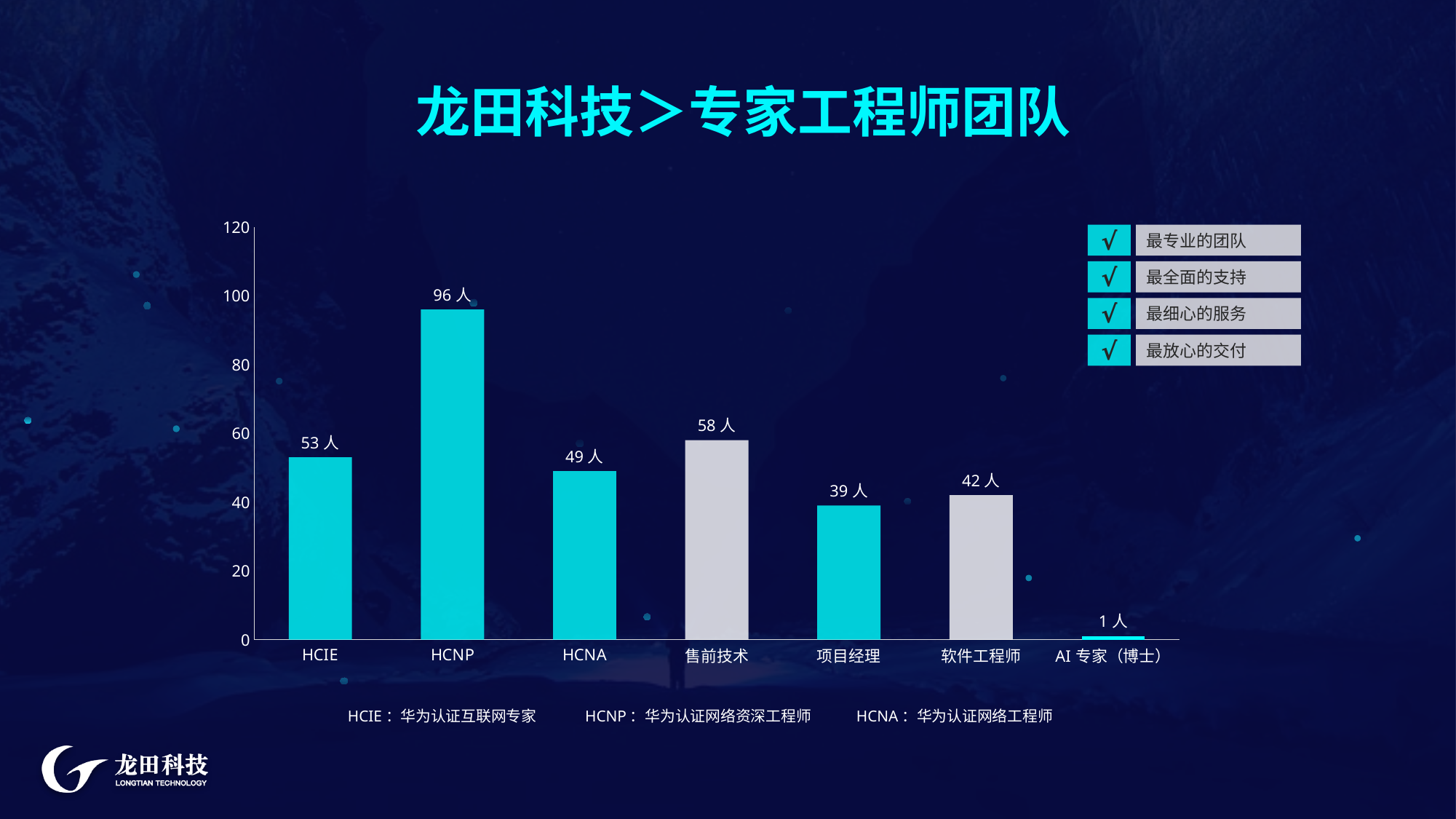
What is the maximum value shown on the y axis? 120 What is the difference between the values for HCNP and HCIE? 43 人 Which category has the lowest value? AI 专家（博士） Is the value for 项目经理 greater or less than 40? less What is the value for HCNP? 96 人 What is the value for AI 专家（博士）? 1 人 How many categories are shown on the x axis? 7 Which is larger, the value for HCNA or the value for 软件工程师? HCNA Which category has the highest value? HCNP What kind of chart is shown on the slide? bar chart What is the difference between the values for 售前技术 and 项目经理? 19 人 What is the value for 售前技术? 58 人